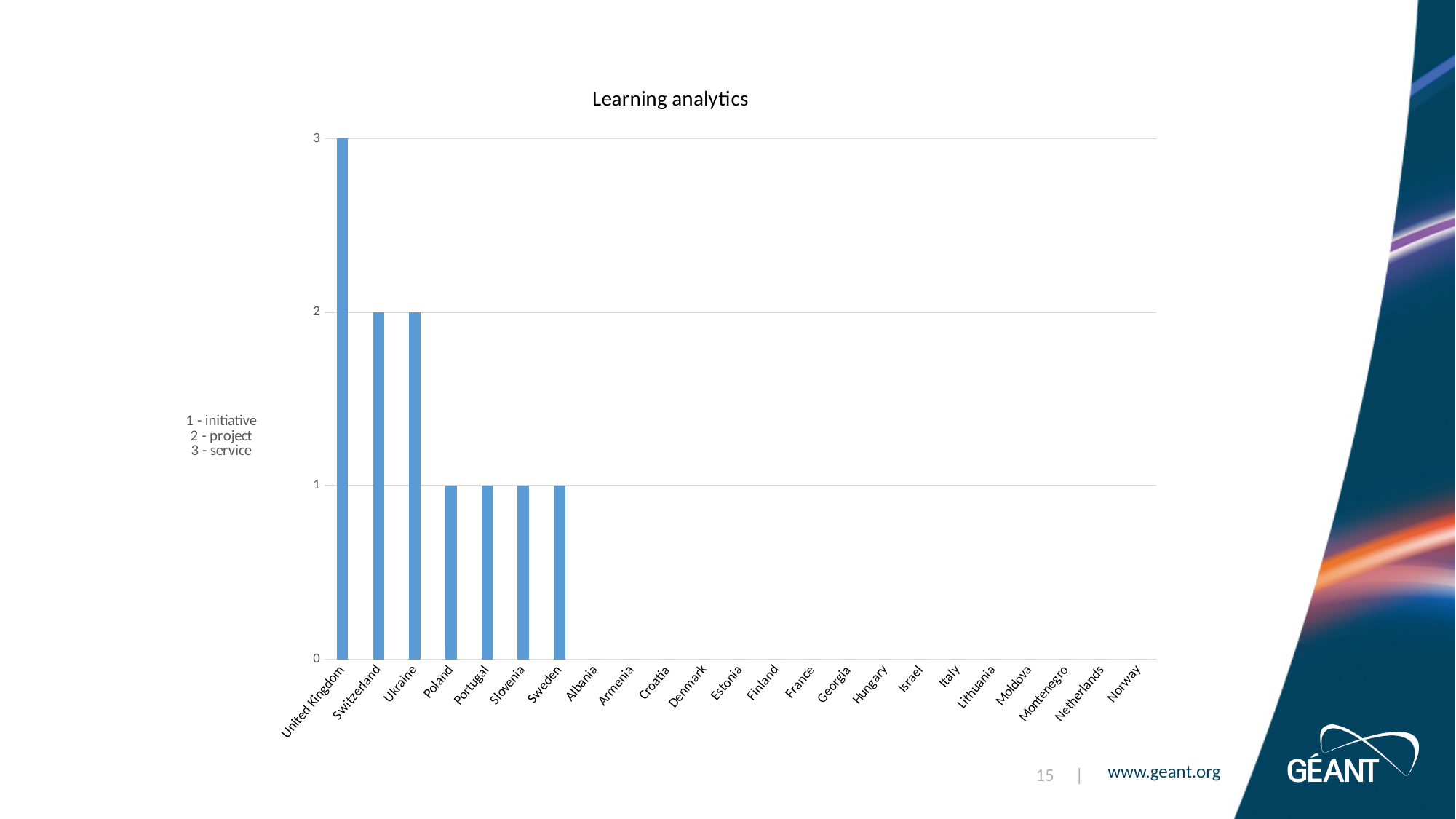
What is the value for Poland? 1 Which has a larger value, Ukraine or Sweden? Ukraine How many countries are listed on the x axis? 23 What is the title of the chart? Learning analytics Do the values rise or fall moving from left to right along the x axis? fall According to the note beside the y axis, what does a value of 3 stand for? service What kind of chart is shown on the slide? bar chart Which country has the highest value? United Kingdom What is the value for Switzerland? 2 What is the value for United Kingdom? 3 What is the difference between the values for United Kingdom and Ukraine? 1 How many countries have a bar with a value of 1? 4